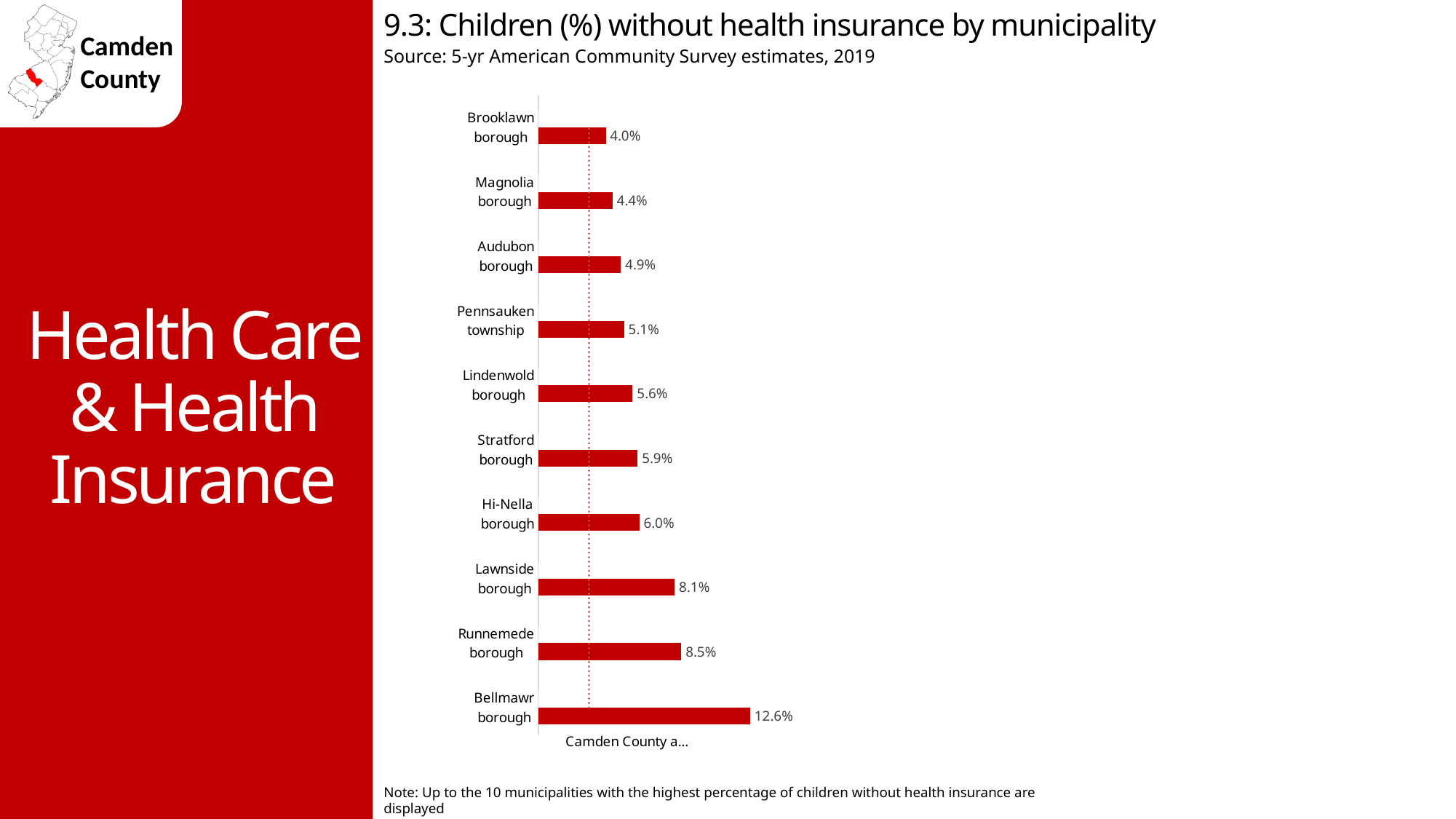
What is the difference in percentage points between Runnemede borough and Lawnside borough? 0.4 percentage points Which has a higher percentage of children without health insurance, Lawnside borough or Hi-Nella borough? Lawnside borough What is the value shown for Pennsauken township? 5.1% How many municipalities are shown on the chart? 10 What percentage of children in Bellmawr borough are without health insurance? 12.6% Which municipality has the lowest percentage of children without health insurance on the chart? Brooklawn borough Which municipality has the highest percentage of children without health insurance? Bellmawr borough What is the title of the chart? 9.3: Children (%) without health insurance by municipality What kind of chart is used on this slide? Bar chart Which has a higher value, Magnolia borough or Audubon borough? Audubon borough What is the difference in percentage points between Bellmawr borough and Brooklawn borough? 8.6 percentage points What percentage is shown for Lindenwold borough? 5.6%